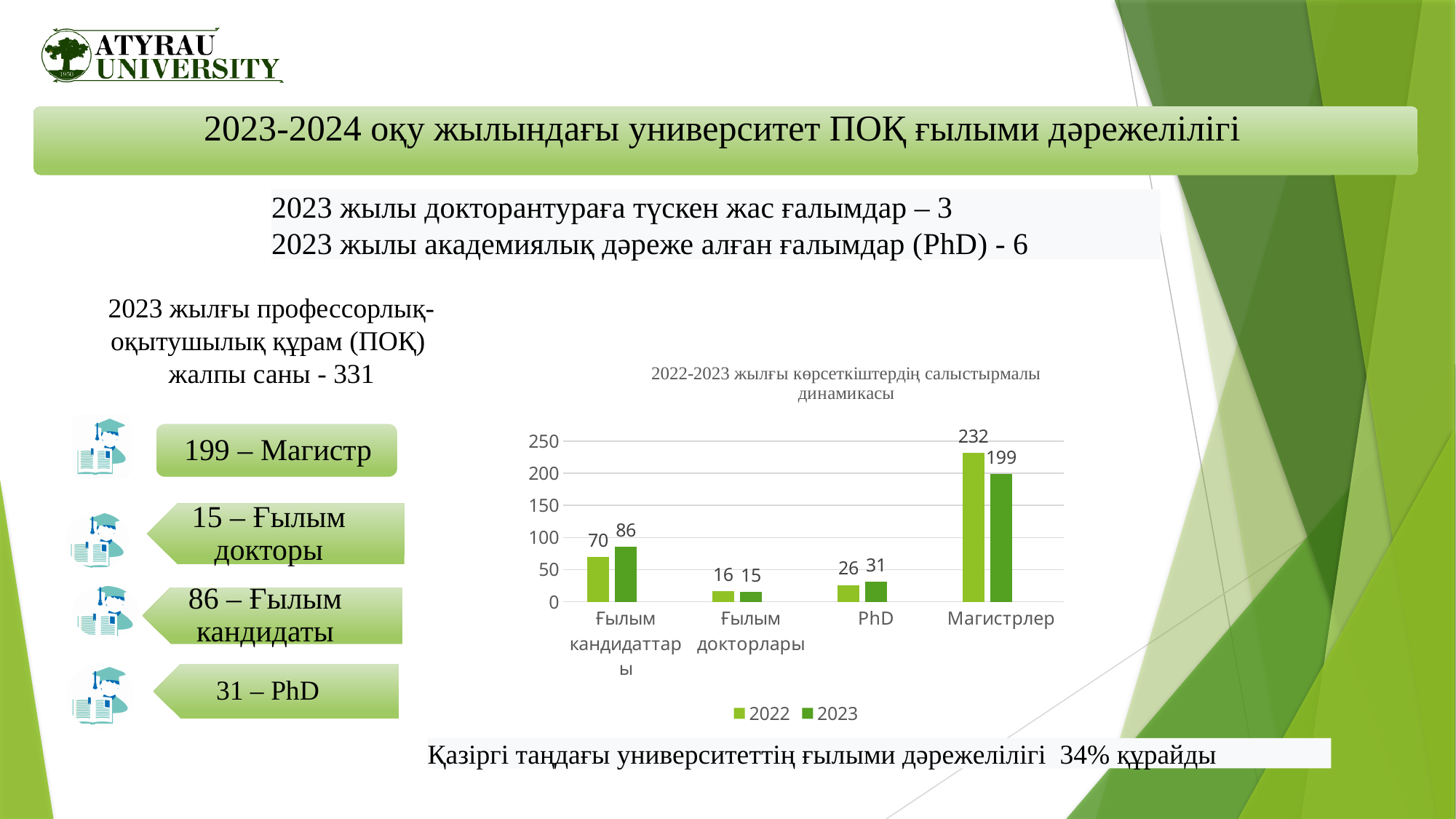
What is the value for Ғылым докторлары in the 2023 series? 15 What is the difference between the 2022 and 2023 values for Магистрлер? 33 Which category has the lowest value in the 2022 series? Ғылым докторлары What is the value for Магистрлер in the 2022 series? 232 What is the value for PhD in the 2022 series? 26 How many series does the chart legend list? 2 What type of chart is shown on the slide? Bar chart Which category has the highest value in the 2023 series? Магистрлер What is the title of the chart? 2022-2023 жылғы көрсеткіштердің салыстырмалы динамикасы How many categories are shown on the x axis of the chart? 4 Which is larger for PhD: the 2022 value or the 2023 value? 2023 What is the value for Ғылым кандидаттары in the 2023 series? 86